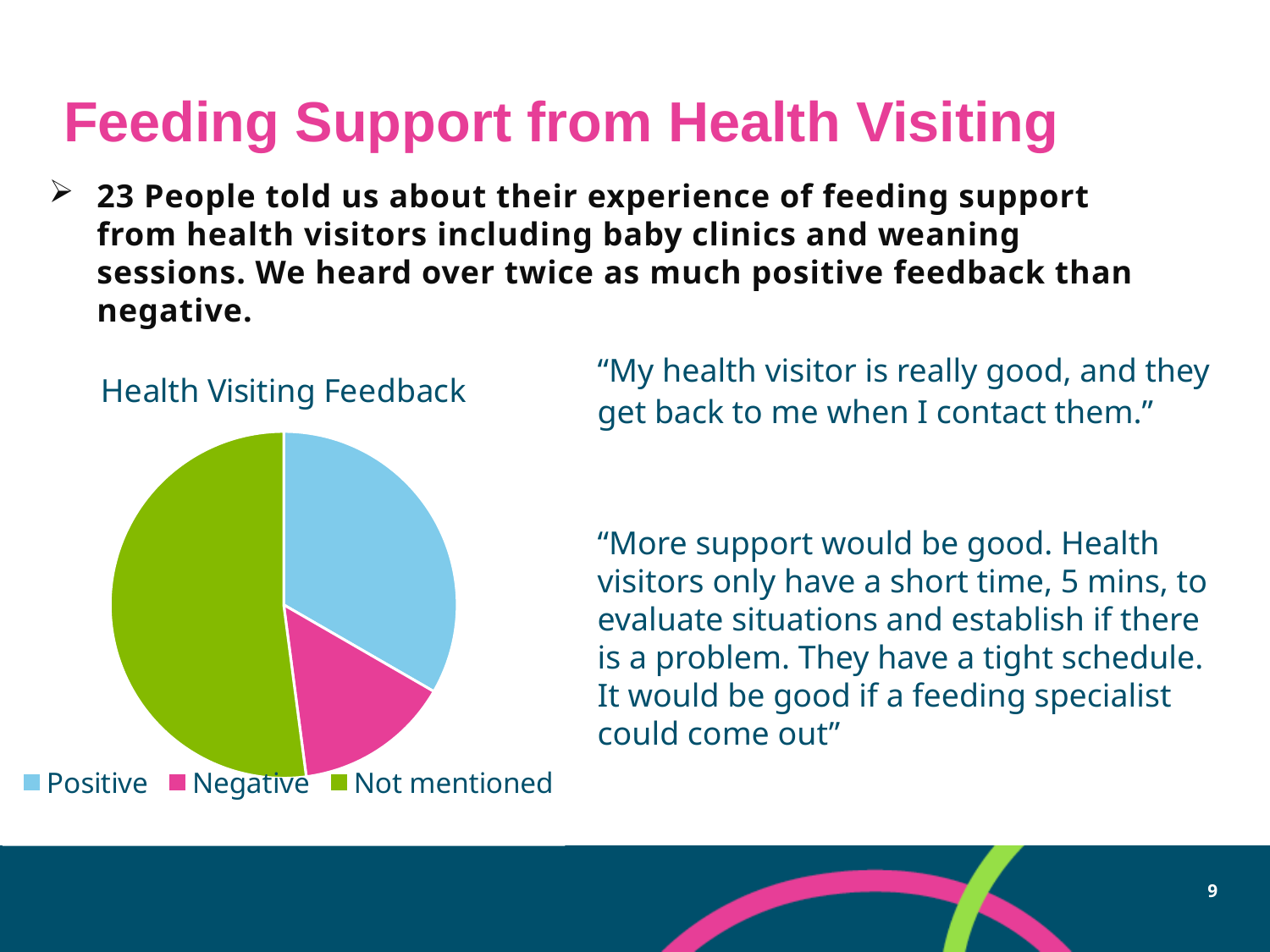
Which slice is larger, Not mentioned or Positive? Not mentioned Which category has the smallest slice of the pie? Negative What kind of chart is shown on the slide? Pie chart Which category has the largest slice of the pie? Not mentioned Which slice is larger, Positive or Negative? Positive Which colour represents the Negative category in the pie chart? Pink How many entries does the chart legend list? 3 Which category is shown in green in the pie chart? Not mentioned What is the title of the chart? Health Visiting Feedback How many slices does the pie chart have? 3